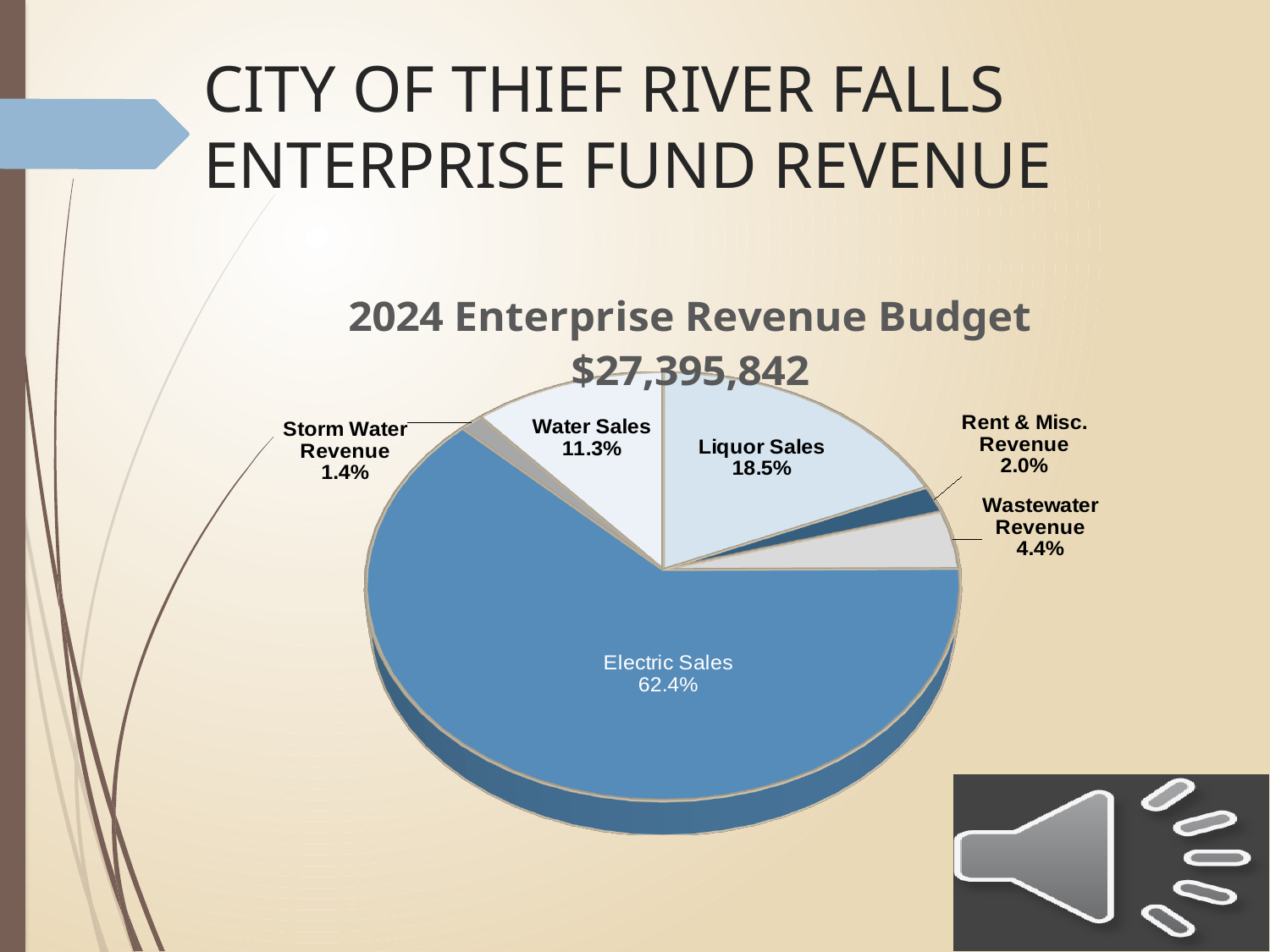
What is the difference in percentage points between Liquor Sales and Water Sales? 7.2 What share of the pie does Liquor Sales represent? 18.5% What share of the pie does Electric Sales represent? 62.4% What is the value shown for Wastewater Revenue? 4.4% Which category has the smallest slice of the pie? Storm Water Revenue What is the value shown for Storm Water Revenue? 1.4% What kind of chart is shown on the slide? Pie chart Which category has the largest slice of the pie? Electric Sales Which is larger, Wastewater Revenue or Rent & Misc. Revenue? Wastewater Revenue What is the value shown for Water Sales? 11.3% What total budget amount is shown in the chart title? $27,395,842 How many categories are shown in the pie chart? 6